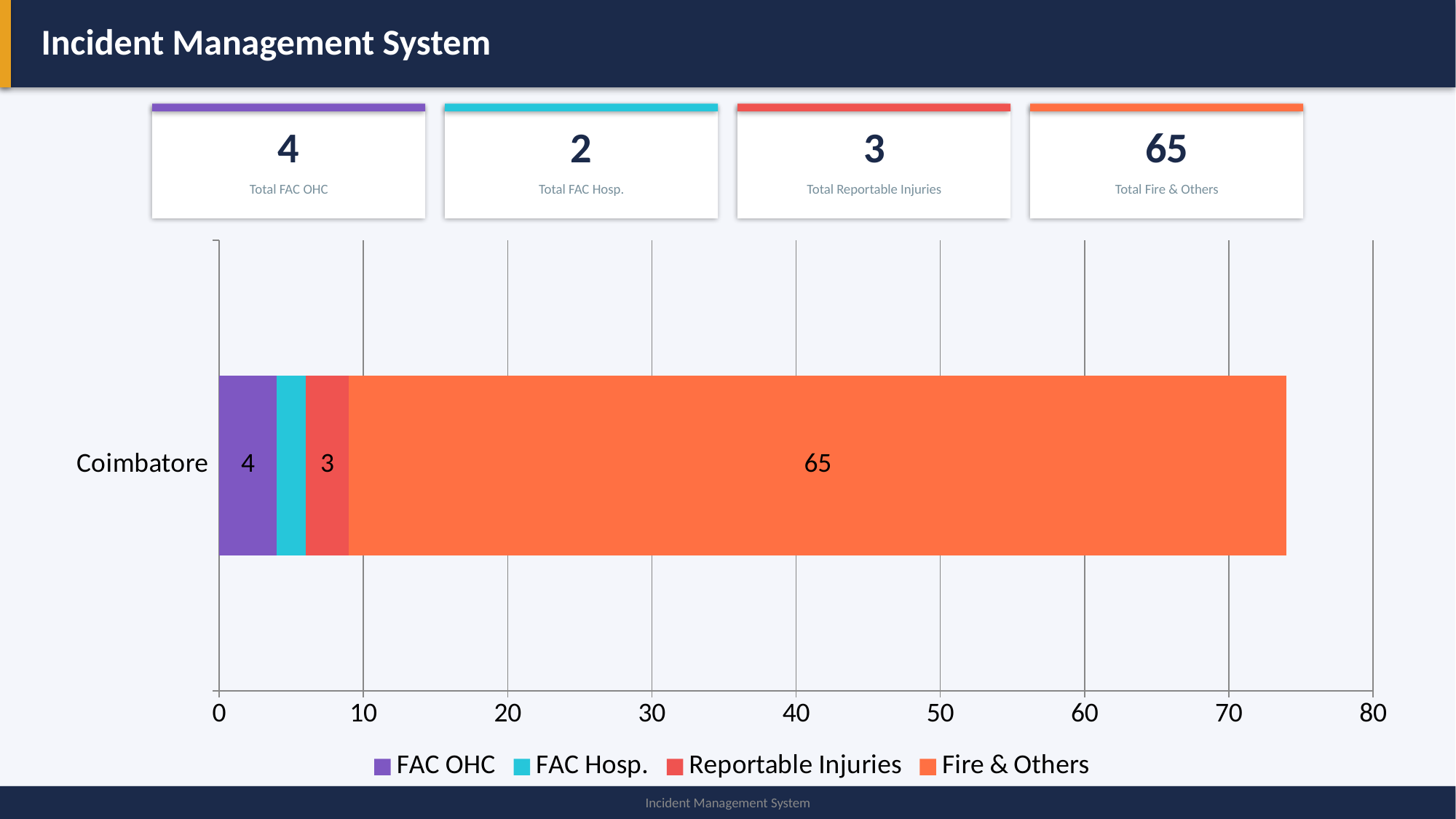
What is the difference between the Fire & Others value and the FAC OHC value for Coimbatore? 61 What is the name of the category shown on the y axis of the chart? Coimbatore What is the FAC OHC value for Coimbatore? 4 Which is larger for Coimbatore, FAC OHC or Reportable Injuries? FAC OHC What is the Reportable Injuries value for Coimbatore? 3 What is the Fire & Others value for Coimbatore? 65 Which series has the largest segment in the Coimbatore bar? Fire & Others How many categories are plotted on the y axis of the chart? 1 Is the total length of the Coimbatore stacked bar greater or less than 70? greater What is the difference between the Fire & Others value and the Reportable Injuries value for Coimbatore? 62 How many series does the chart legend list? 4 What kind of chart is shown on the slide? bar chart